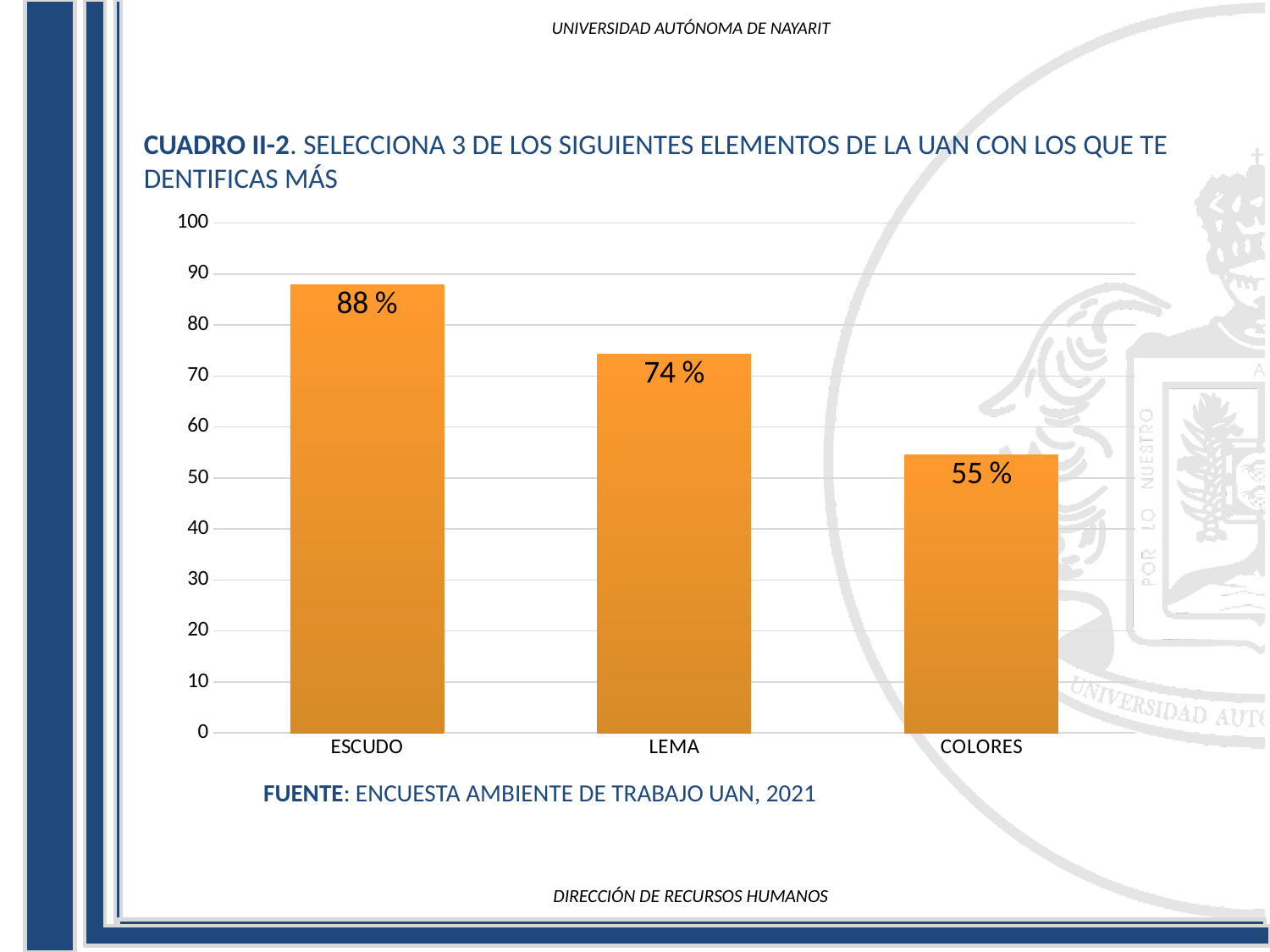
Do the values rise or fall from left to right along the x axis? fall Which category has the lowest value? COLORES Which is larger, the value for LEMA or the value for COLORES? LEMA Which category has the highest value? ESCUDO What kind of chart is shown on the slide? bar chart What is the difference between the values for LEMA and COLORES? 19 % What is the value for COLORES? 55 % How many categories are shown on the x axis? 3 Is the value for COLORES greater or less than 60? less What is the value for LEMA? 74 % What is the difference between the values for ESCUDO and LEMA? 14 % What is the value for ESCUDO? 88 %